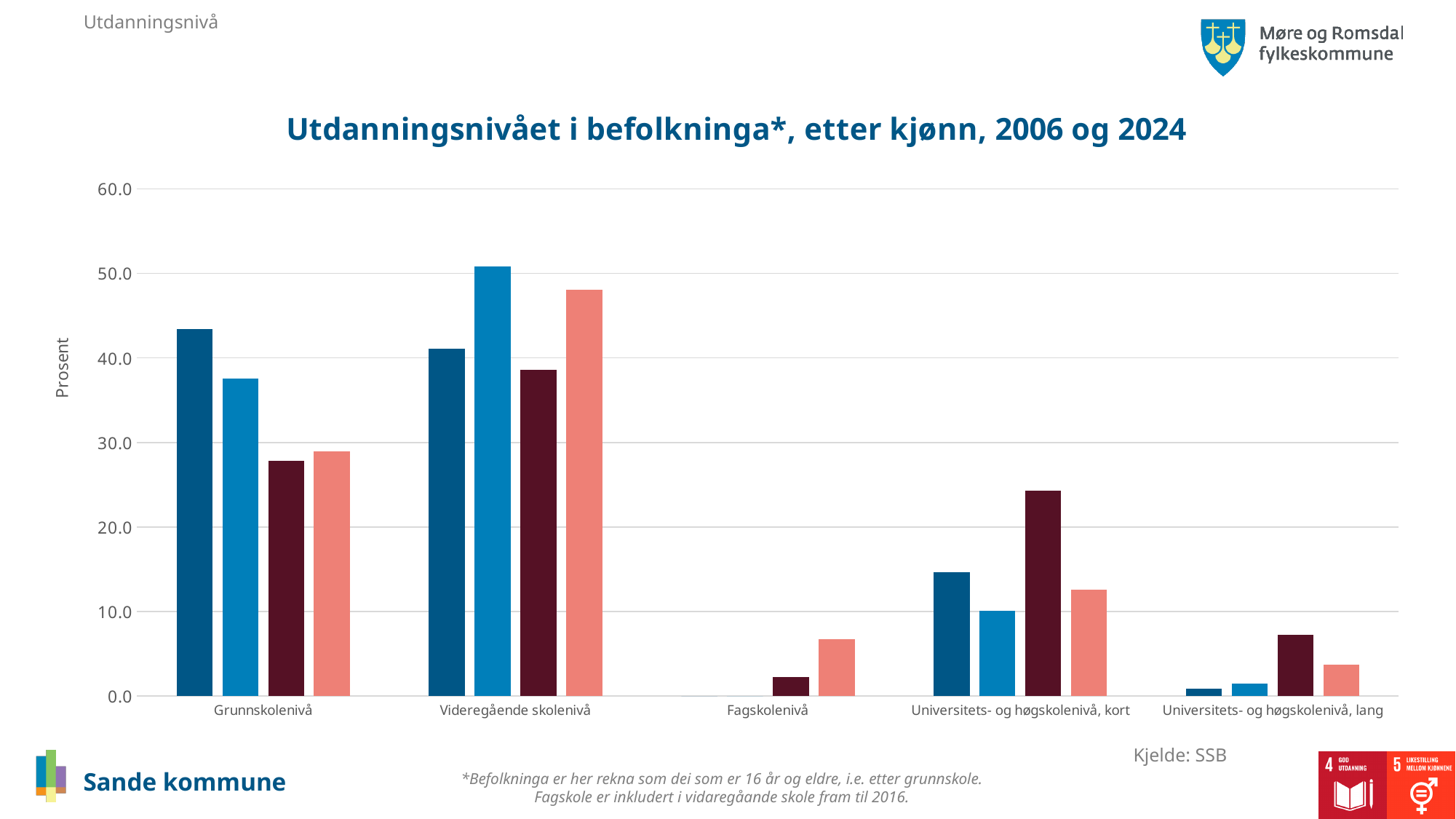
Which category contains the tallest bar in the chart? Videregående skolenivå How many bars are shown for the Grunnskolenivå category? 4 Is the value of the salmon bar for Videregående skolenivå greater or less than 50? less Is the value of the dark blue bar for Grunnskolenivå greater or less than 40? greater In which category is the dark maroon bar the lowest? Fagskolenivå Is the value of the salmon bar for Fagskolenivå greater or less than 10? less How many education-level categories are shown on the x axis? 5 What is the title of the chart? Utdanningsnivået i befolkninga*, etter kjønn, 2006 og 2024 What source is cited for the chart? SSB What kind of chart is shown on the slide? bar chart For Grunnskolenivå, which is larger: the dark blue bar or the dark maroon bar? the dark blue bar